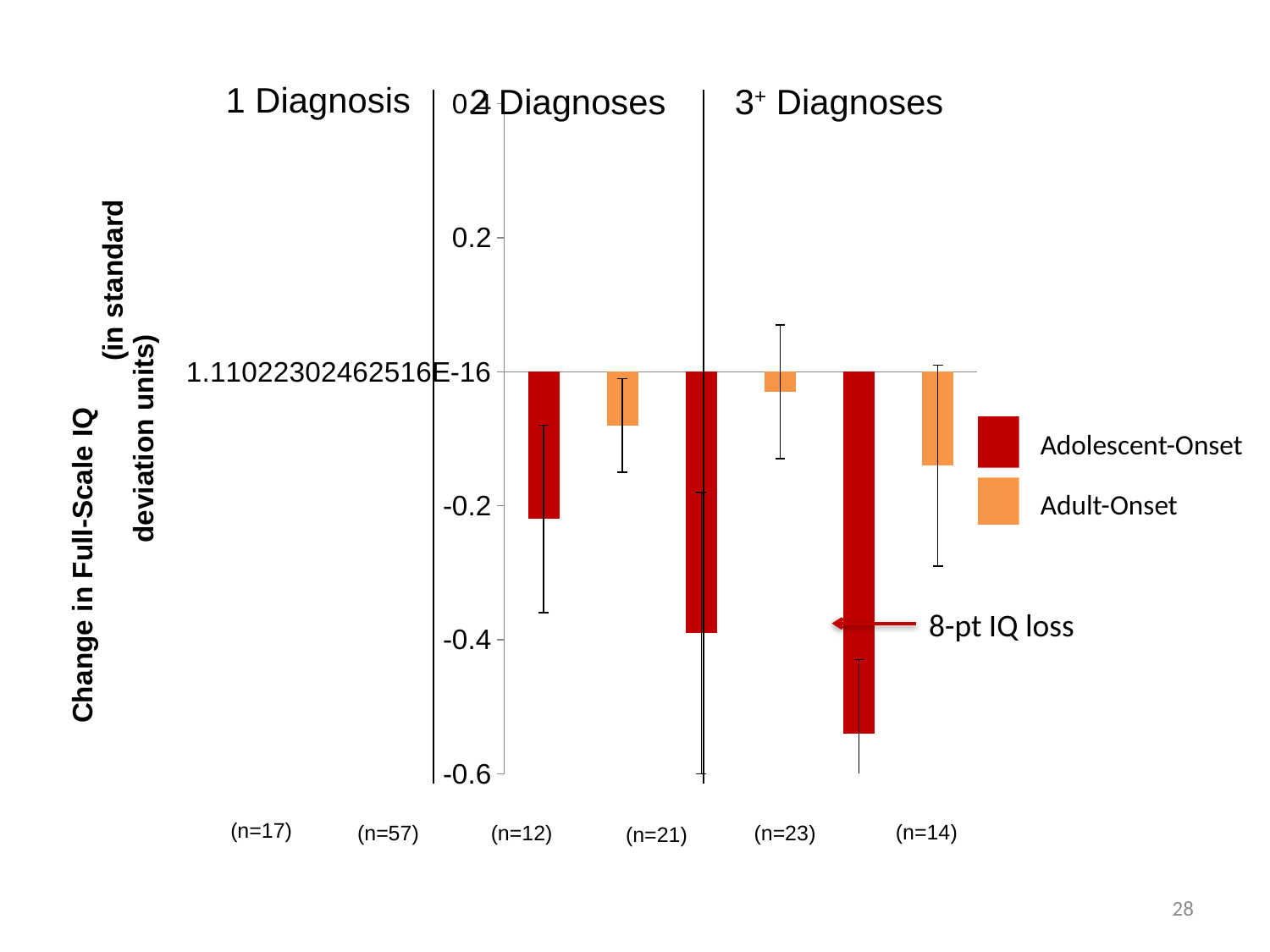
In the rightmost pair of bars, which series has the larger (less negative) value, Adolescent-Onset or Adult-Onset? Adult-Onset Is the value of the rightmost Adolescent-Onset (dark red) bar greater or less than -0.4? less Is the value of the rightmost Adolescent-Onset (dark red) bar greater or less than -0.6? greater How many series does the legend list? 2 Is the value of the rightmost Adult-Onset (orange) bar greater or less than -0.2? greater Do the Adolescent-Onset (dark red) bars rise or fall from left to right across the chart? fall What kind of chart is shown on the slide? bar chart What text does the red arrow annotation on the chart point with? 8-pt IQ loss How many bars are plotted in the chart? 6 What are the two series named in the legend? Adolescent-Onset and Adult-Onset Which bar has the lowest value in the chart? the rightmost Adolescent-Onset bar